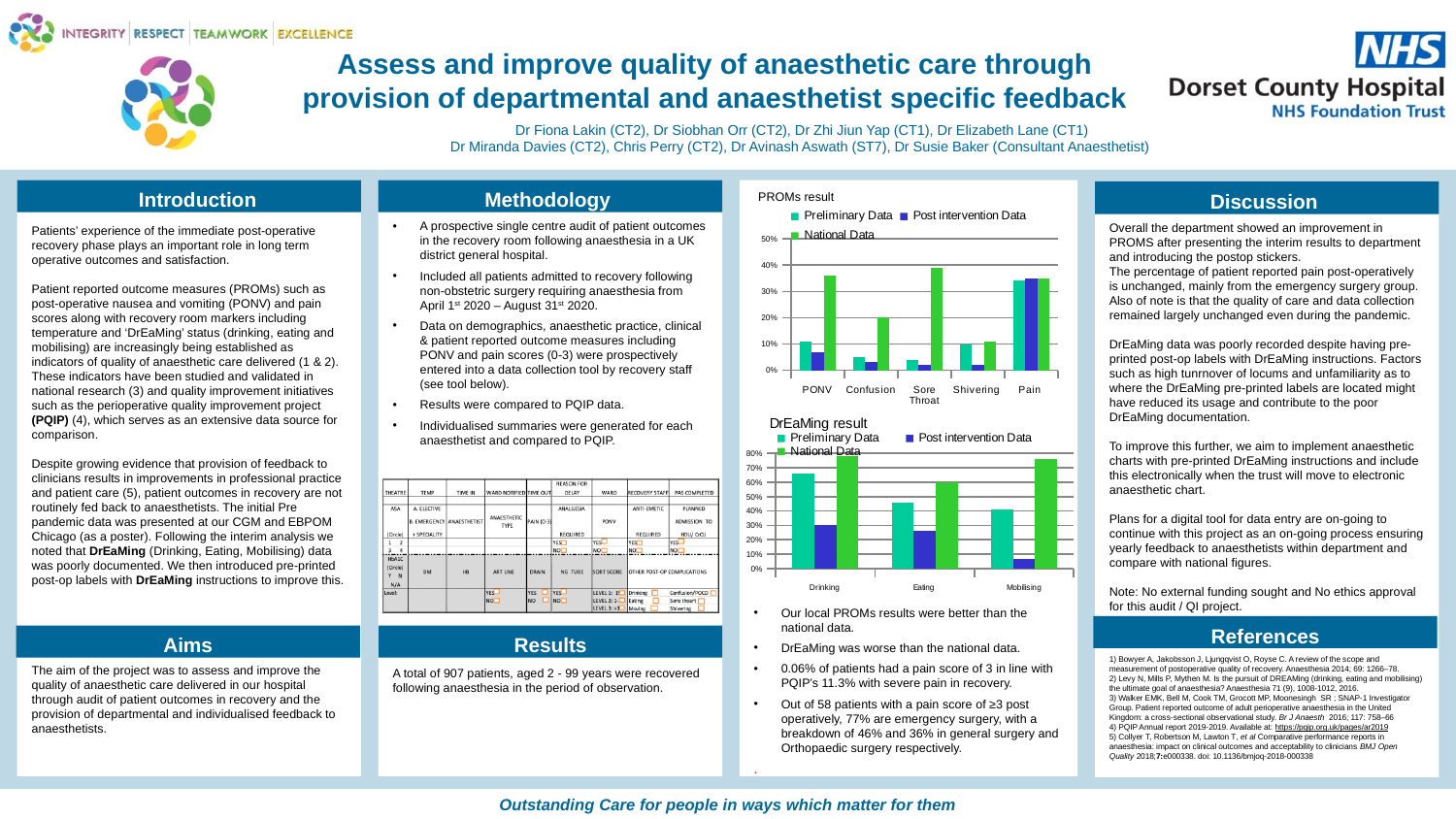
How many series does the legend of the PROMs result chart list? 3 How many categories are shown on the x axis of the PROMs result chart? 5 In the DrEaMing result chart, does the Post intervention Data series rise or fall from Drinking to Mobilising? fall In the DrEaMing result chart, which category has the lowest Post intervention Data value? Mobilising In the DrEaMing result chart, is the National Data value for Drinking greater or less than 60%? greater In the PROMs result chart, which category has the lowest National Data value? Shivering In the PROMs result chart, is the National Data value for PONV greater or less than 30%? greater In the DrEaMing result chart, is the Post intervention Data value for Mobilising greater or less than 20%? less How many categories are shown on the x axis of the DrEaMing result chart? 3 What kind of chart is the PROMs result chart? bar chart In the PROMs result chart, for Sore Throat, which is larger: the National Data value or the Preliminary Data value? National Data